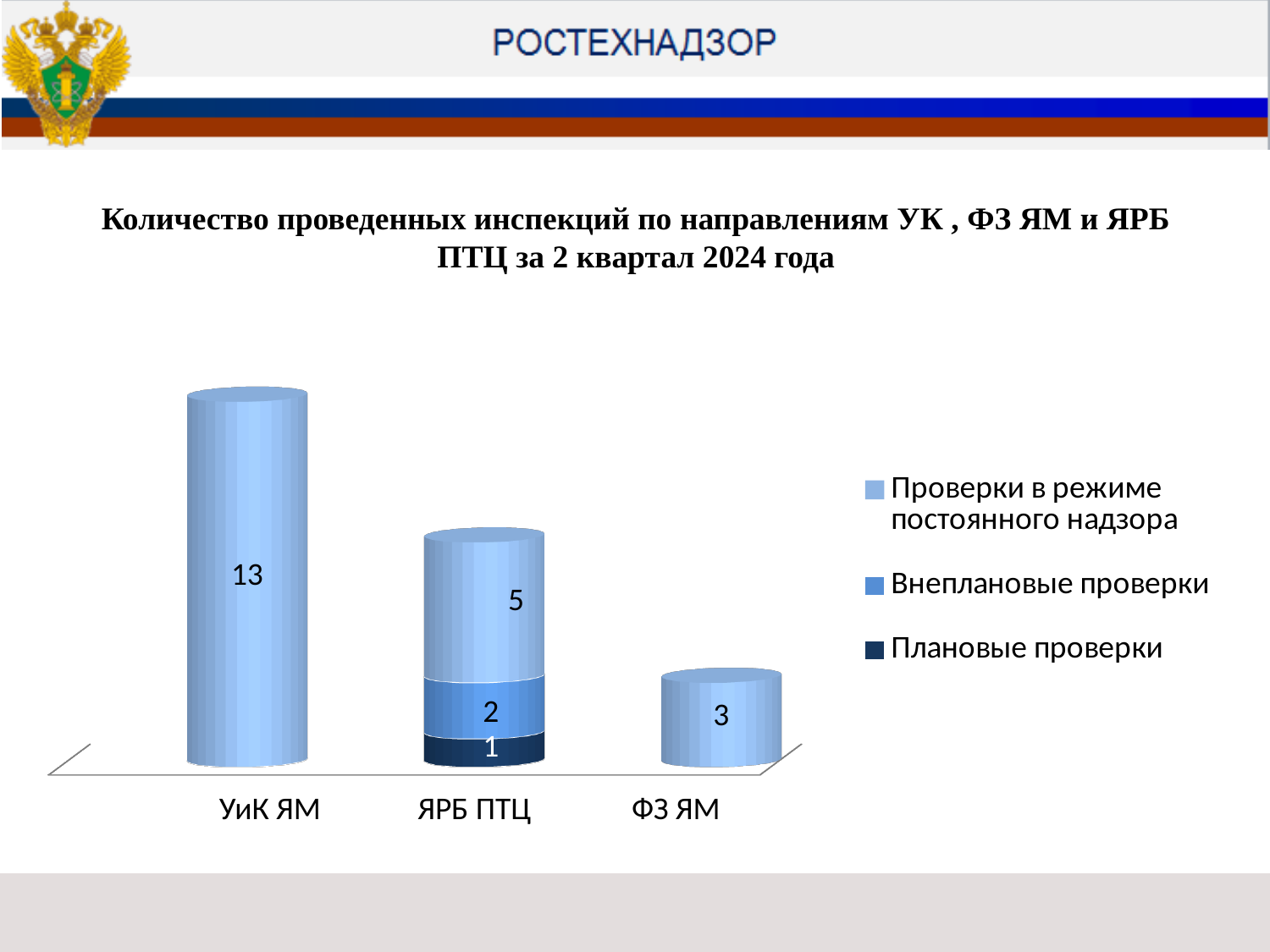
What is the difference between the Проверки в режиме постоянного надзора values for УиК ЯМ and ФЗ ЯМ? 10 What is the value for Проверки в режиме постоянного надзора for УиК ЯМ? 13 What is the value for Проверки в режиме постоянного надзора for ЯРБ ПТЦ? 5 How many categories are shown on the x axis? 3 What is the value for Проверки в режиме постоянного надзора for ФЗ ЯМ? 3 What is the value for Плановые проверки for ЯРБ ПТЦ? 1 Which category has the highest total number of inspections? УиК ЯМ What is the value for Внеплановые проверки for ЯРБ ПТЦ? 2 What is the total of the stacked bar for ЯРБ ПТЦ? 8 How many series does the legend list? 3 What kind of chart is shown on the slide? Stacked bar chart Which category has the lowest total number of inspections? ФЗ ЯМ